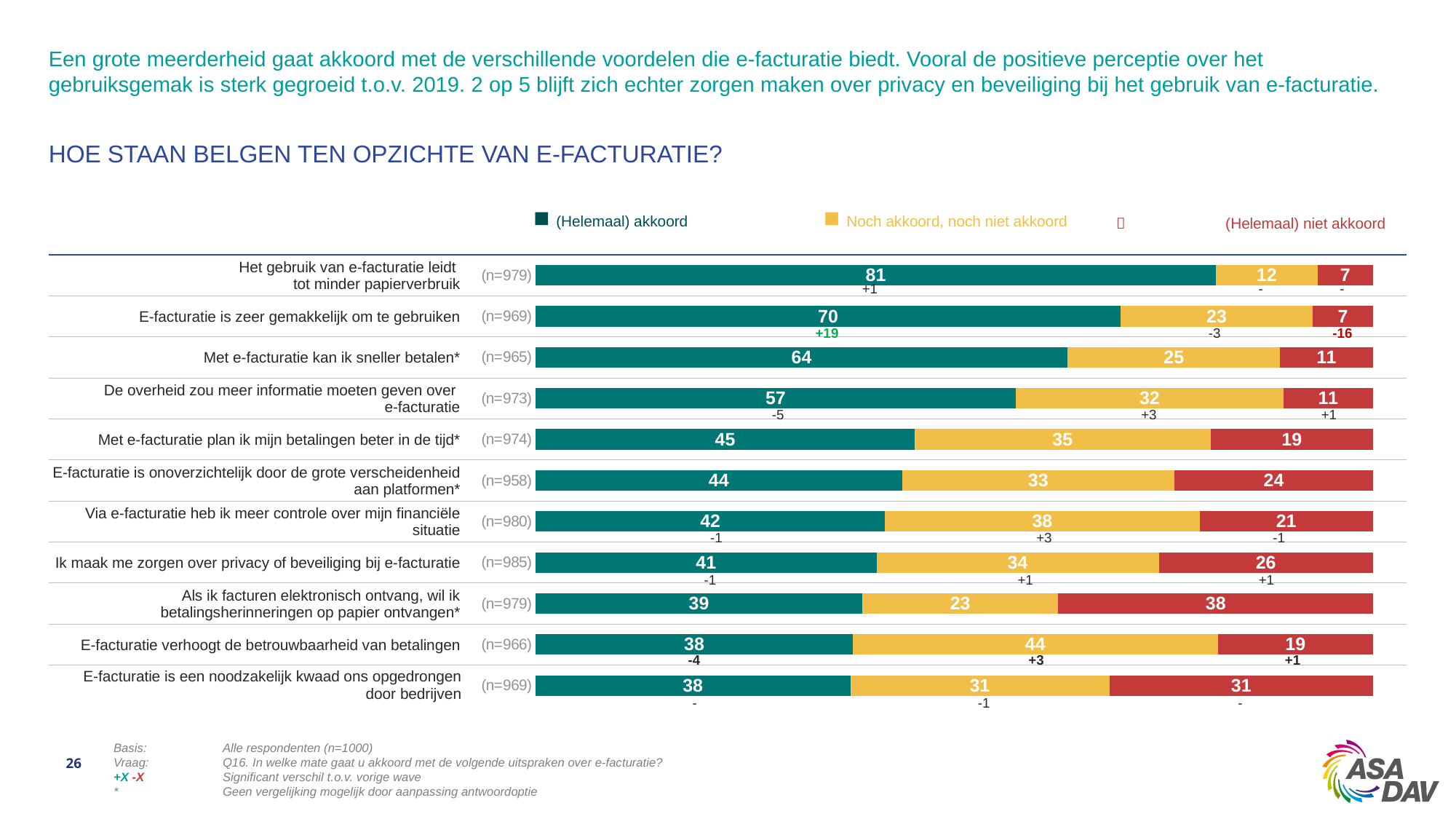
What is the 'Noch akkoord, noch niet akkoord' value for 'E-facturatie verhoogt de betrouwbaarheid van betalingen'? 44 What is the '(Helemaal) akkoord' value for 'Het gebruik van e-facturatie leidt tot minder papierverbruik'? 81 What is the sample size (n) shown for 'Ik maak me zorgen over privacy of beveiliging bij e-facturatie'? n=985 How many statements (categories) are plotted in the chart? 11 Which is larger: the '(Helemaal) niet akkoord' value for 'Ik maak me zorgen over privacy of beveiliging bij e-facturatie' or for 'E-facturatie is onoverzichtelijk door de grote verscheidenheid aan platformen*'? Ik maak me zorgen over privacy of beveiliging bij e-facturatie What is the total of the stacked bar for 'Met e-facturatie kan ik sneller betalen*'? 100 What is the difference between the '(Helemaal) akkoord' values for 'E-facturatie is zeer gemakkelijk om te gebruiken' and 'Met e-facturatie kan ik sneller betalen*'? 6 What is the '(Helemaal) niet akkoord' value for 'Als ik facturen elektronisch ontvang, wil ik betalingsherinneringen op papier ontvangen*'? 38 What type of chart is shown on the slide? Stacked bar chart Which statement has the highest '(Helemaal) akkoord' value? Het gebruik van e-facturatie leidt tot minder papierverbruik How many series does the legend list? 3 Which statement has the lowest '(Helemaal) niet akkoord' value among those with a value of 11 or more? Met e-facturatie kan ik sneller betalen* and De overheid zou meer informatie moeten geven over e-facturatie (both 11)